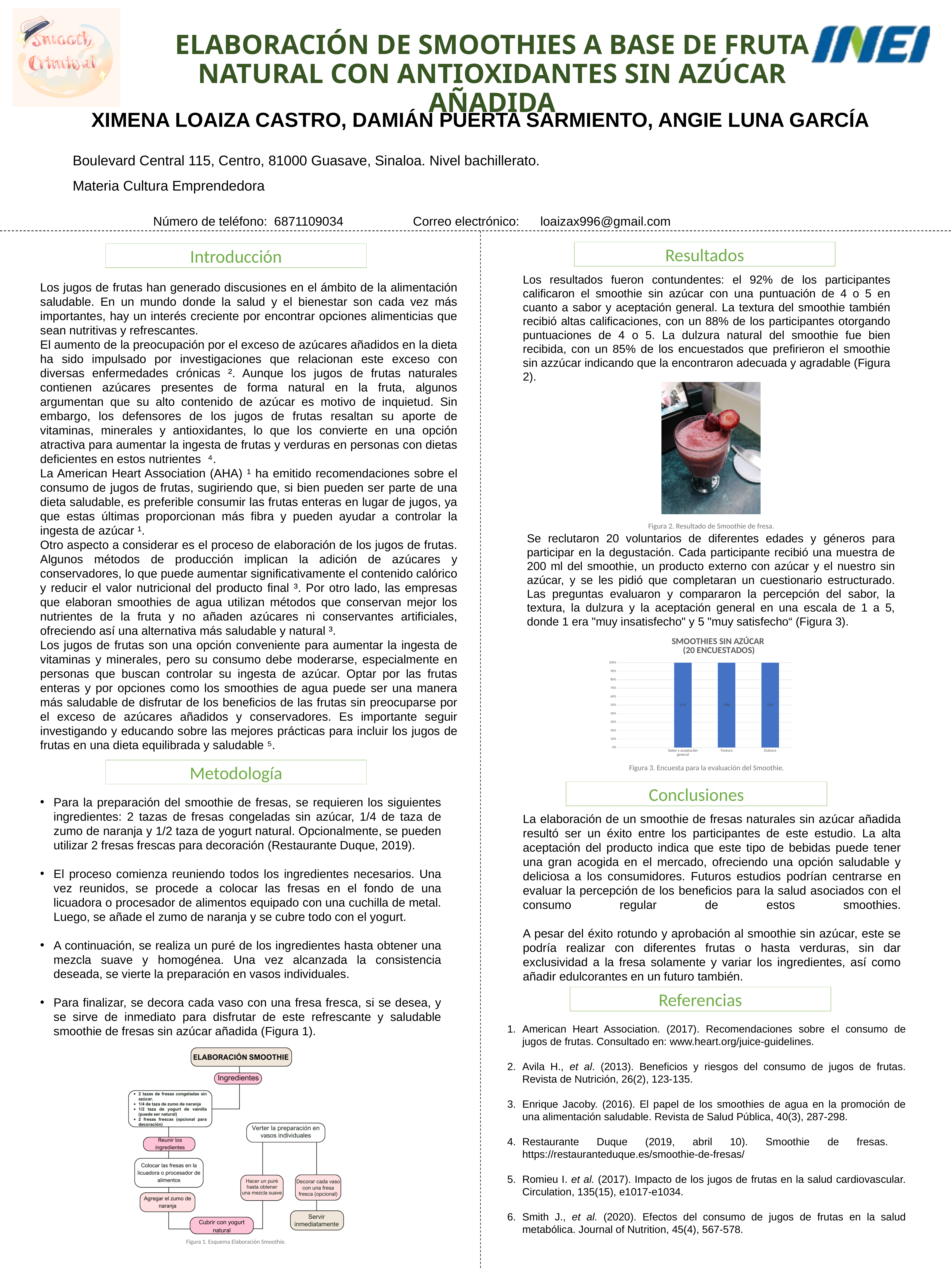
Which categories appear on the x axis of the chart in Figura 3? Sabor y aceptación general, Textura, Dulzura What is the highest tick shown on the y axis of the chart in Figura 3? 100% In the chart in Figura 3, is the value for Textura greater or less than 50%? greater In the chart in Figura 3, is the value for Sabor y aceptación general greater or less than 50%? greater In the chart in Figura 3, is the value for Dulzura greater or less than 20%? greater How many respondents does the title of the chart in Figura 3 say were surveyed? 20 How many categories are plotted on the x axis of the chart in Figura 3? 3 What kind of chart is shown in Figura 3? bar chart